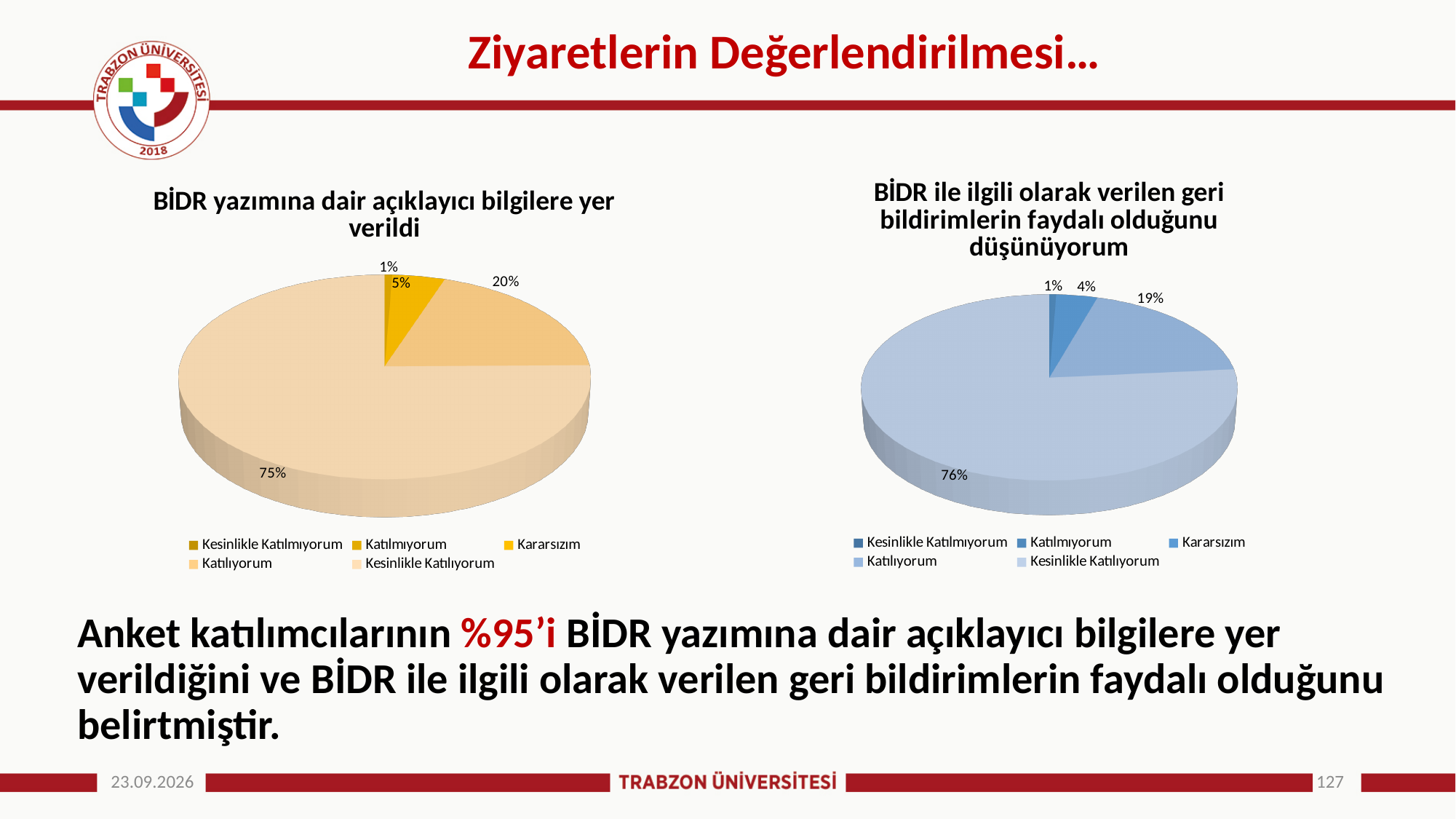
In the left pie chart (BİDR yazımına dair açıklayıcı bilgilere yer verildi), what share is labelled for Kararsızım? 5% What type of chart is used on the left of the slide (BİDR yazımına dair açıklayıcı bilgilere yer verildi)? Pie chart In the left pie chart (BİDR yazımına dair açıklayıcı bilgilere yer verildi), what share is labelled for Kesinlikle Katılıyorum? 75% In the left pie chart (BİDR yazımına dair açıklayıcı bilgilere yer verildi), what share is labelled for Katılıyorum? 20% How many categories does the legend of the right pie chart (BİDR ile ilgili olarak verilen geri bildirimlerin faydalı olduğunu düşünüyorum) list? 5 In the right pie chart (BİDR ile ilgili olarak verilen geri bildirimlerin faydalı olduğunu düşünüyorum), what share is labelled for Kararsızım? 4% In the right pie chart (BİDR ile ilgili olarak verilen geri bildirimlerin faydalı olduğunu düşünüyorum), which category has the largest slice? Kesinlikle Katılıyorum Which is larger: the Katılıyorum share in the left pie chart or the Katılıyorum share in the right pie chart? The left pie chart (20%) In the right pie chart (BİDR ile ilgili olarak verilen geri bildirimlerin faydalı olduğunu düşünüyorum), what share is labelled for Katılıyorum? 19% In the left pie chart (BİDR yazımına dair açıklayıcı bilgilere yer verildi), which category has the largest slice? Kesinlikle Katılıyorum In the left pie chart (BİDR yazımına dair açıklayıcı bilgilere yer verildi), how many percentage points larger is the Kesinlikle Katılıyorum slice than the Katılıyorum slice? 55 percentage points In the right pie chart (BİDR ile ilgili olarak verilen geri bildirimlerin faydalı olduğunu düşünüyorum), what share is labelled for Kesinlikle Katılıyorum? 76%